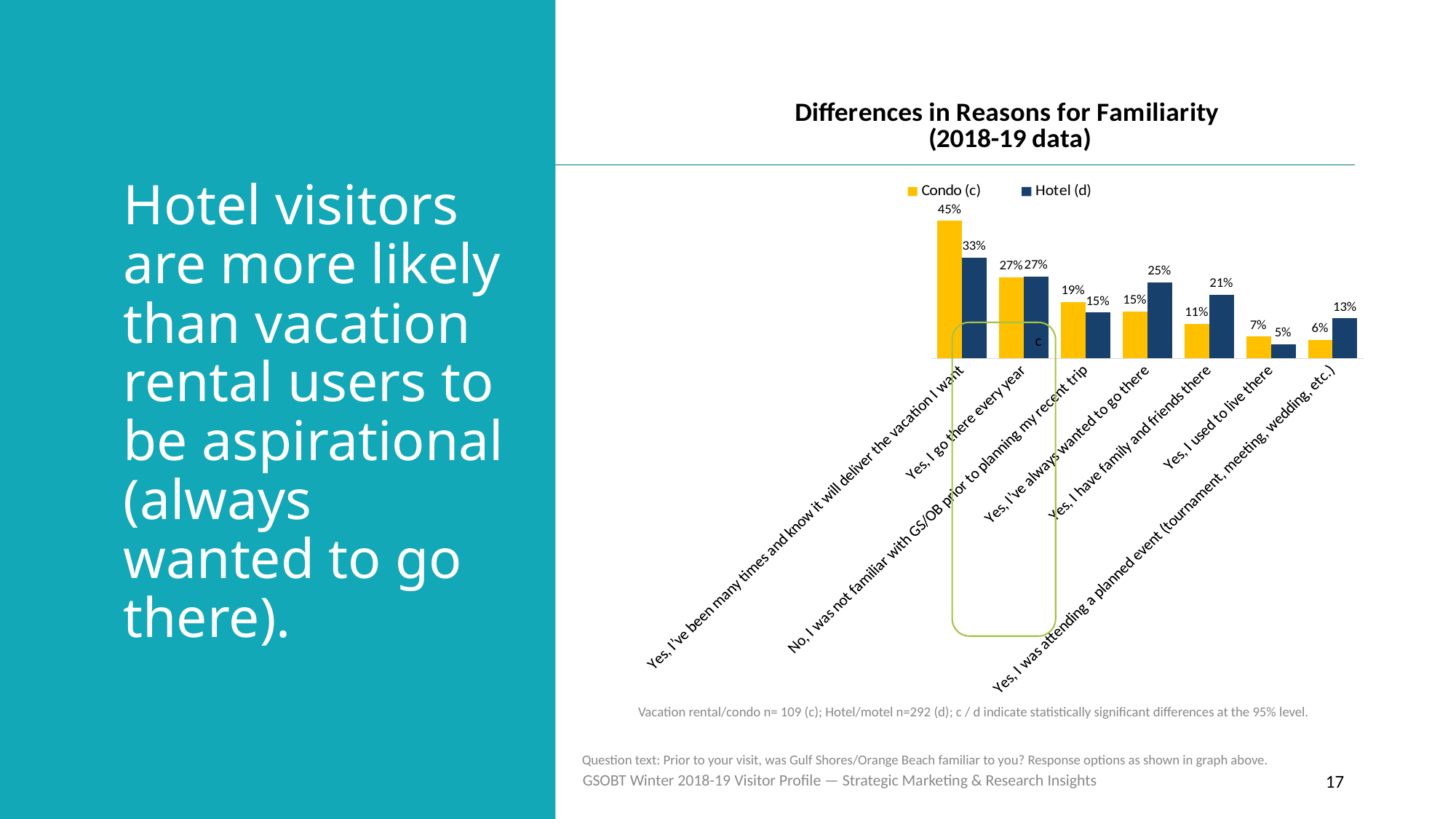
Which category has the highest Condo (c) value? Yes, I've been many times and know it will deliver the vacation I want What kind of chart is shown on the slide? Bar chart What is the Condo (c) value for "Yes, I have family and friends there"? 11% How many series does the legend list? 2 What is the Condo (c) value for "Yes, I've been many times and know it will deliver the vacation I want"? 45% What is the title of the chart? Differences in Reasons for Familiarity (2018-19 data) For "No, I was not familiar with GS/OB prior to planning my recent trip", which series has the larger value, Condo (c) or Hotel (d)? Condo (c) How many categories are shown on the x axis? 7 What is the Hotel (d) value for "Yes, I was attending a planned event (tournament, meeting, wedding, etc.)"? 13% Which category has the lowest Hotel (d) value? Yes, I used to live there What is the difference between the Hotel (d) and Condo (c) values for "Yes, I've always wanted to go there"? 10% What is the Hotel (d) value for "Yes, I've always wanted to go there"? 25%